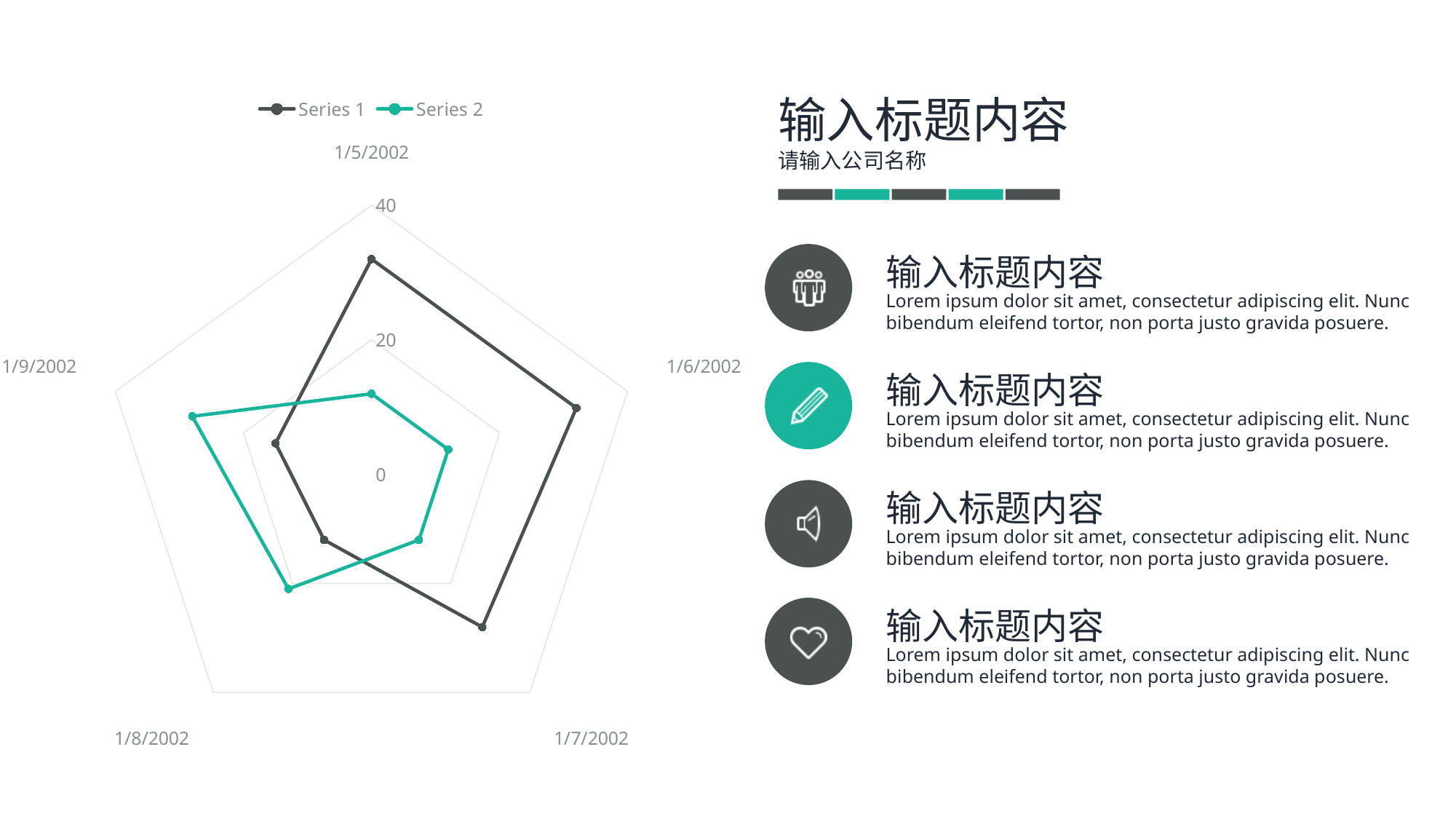
Is the value for Series 2 at 1/9/2002 greater or less than 20? greater How many series does the legend list? 2 Is the value for Series 2 at 1/5/2002 greater or less than 20? less Is the value for Series 1 at 1/6/2002 greater or less than 40? less At 1/5/2002, which series has the larger value, Series 1 or Series 2? Series 1 For Series 2, which category has the highest value? 1/9/2002 What is the highest value shown on the radar chart's axis scale? 40 At 1/9/2002, which series has the larger value, Series 1 or Series 2? Series 2 How many categories (axes) does the radar chart have? 5 What kind of chart is shown on the slide? radar chart